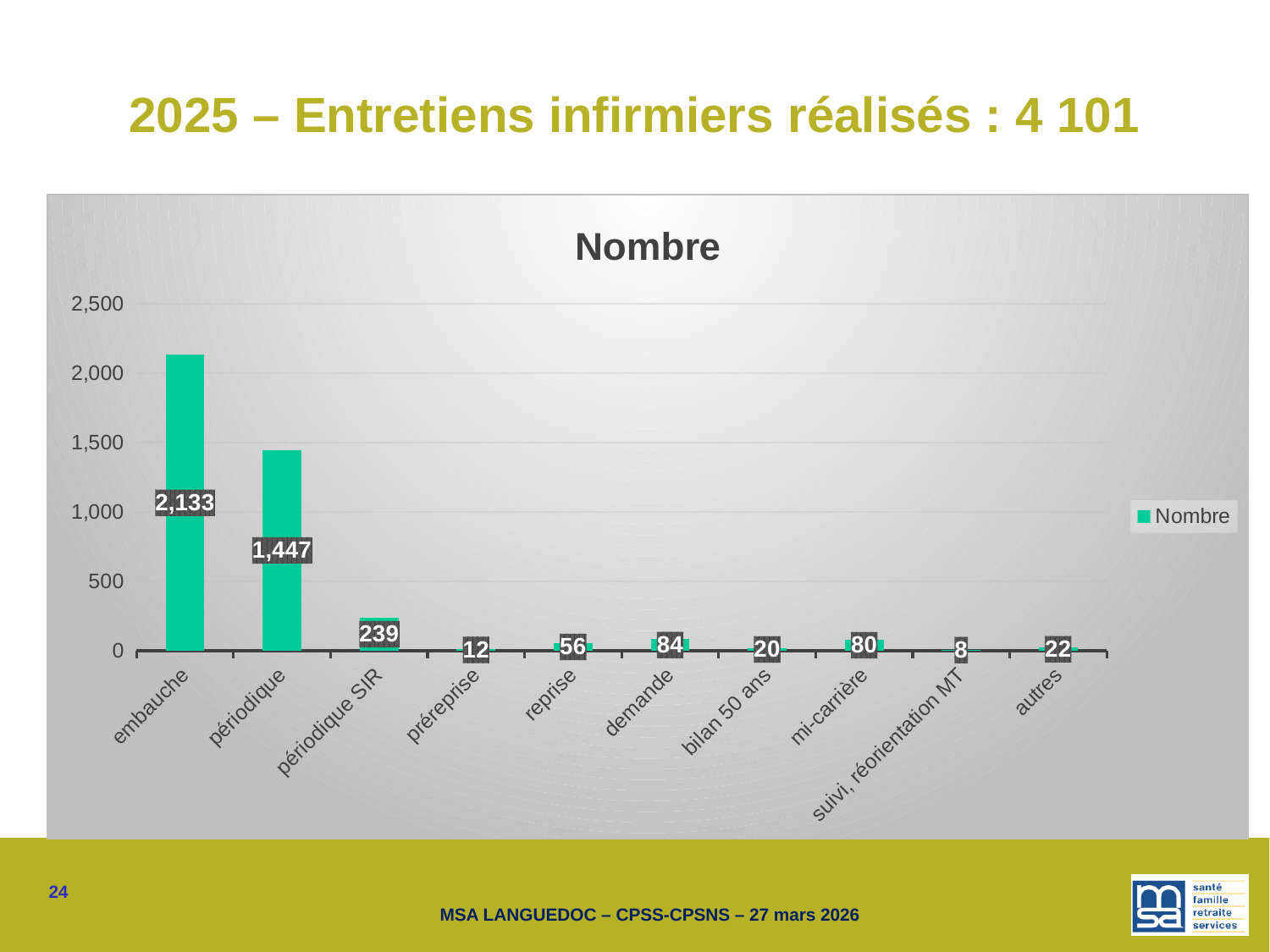
What is the value for périodique SIR? 239 Which category has the highest value? embauche What is the value for demande? 84 What is the value for embauche? 2,133 Is the value for périodique greater or less than 1,000? greater What is the title of the chart? Nombre What kind of chart is shown on the slide? bar chart Which is larger, the value for reprise or the value for mi-carrière? mi-carrière Which category has the lowest value? suivi, réorientation MT What is the difference between the values for embauche and périodique? 686 What is the value for suivi, réorientation MT? 8 How many categories are shown on the x axis? 10